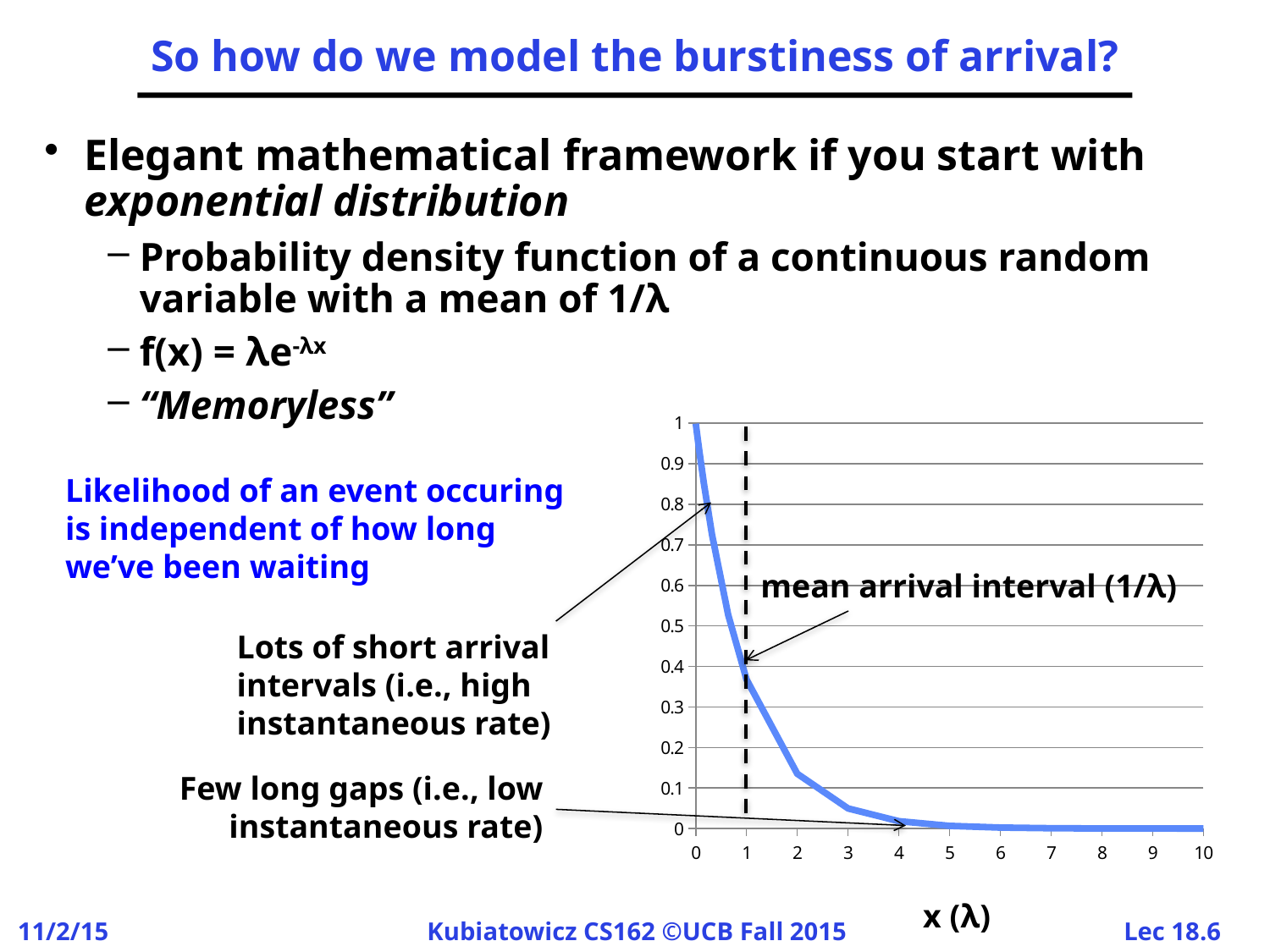
What is the largest value shown on the x axis? 10 Is the value of the curve at x = 1 greater or less than 0.3? greater What is the value of the curve at x = 0? 1 Is the value of the curve at x = 1 greater or less than 0.5? less Is the value of the curve at x = 2 greater or less than 0.2? less Do the plotted values rise or fall as x increases along the x axis? fall Which is larger, the value of the curve at x = 1 or at x = 4? x = 1 What is the label of the x axis? x (λ) What kind of chart is shown on the slide? line chart At which x value does the curve reach its highest point? 0